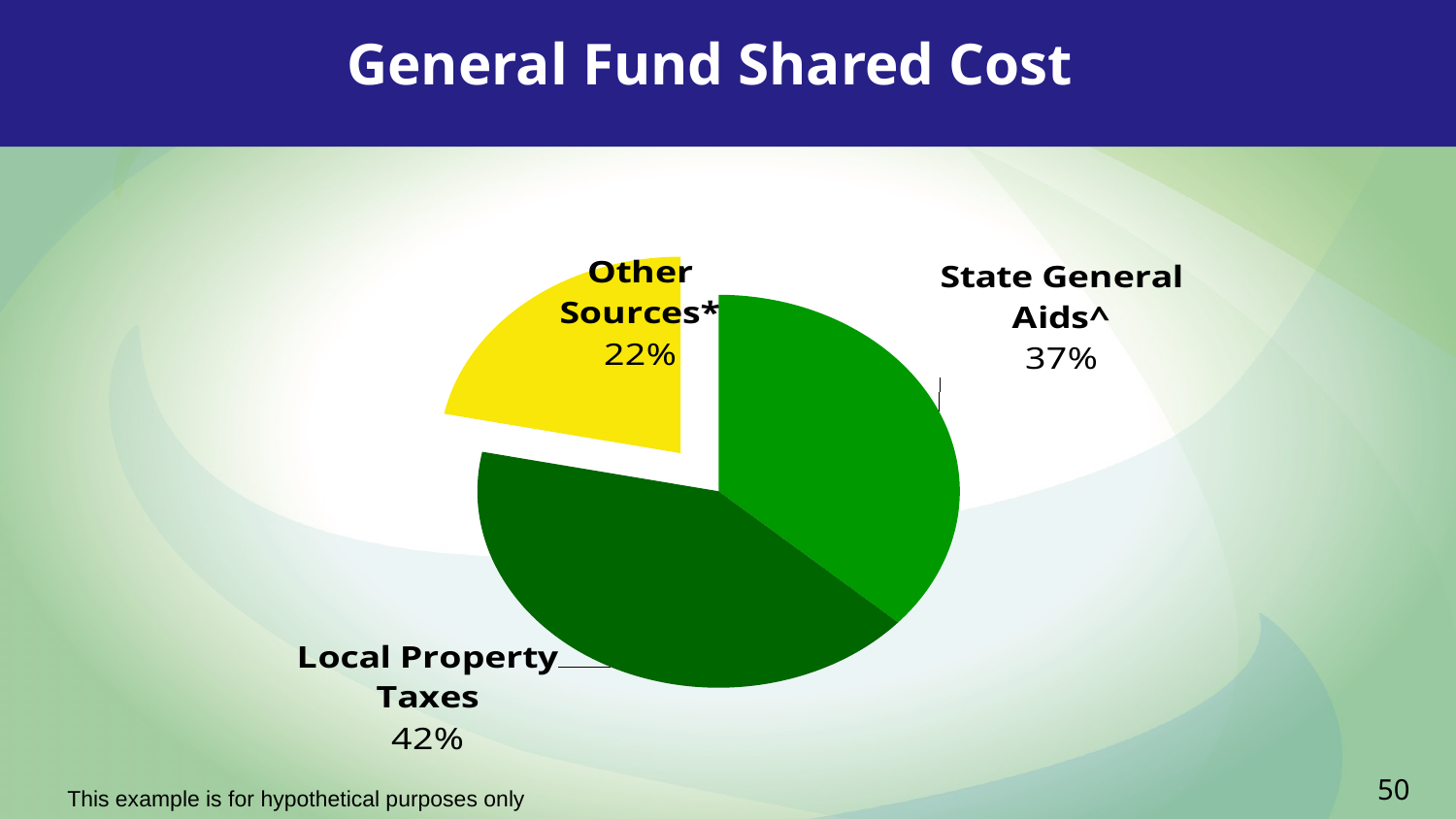
How many slices does the pie chart have? 3 Which slice is the smallest? Other Sources* What is the difference in percentage points between Local Property Taxes and Other Sources*? 20 Which is larger, State General Aids^ or Other Sources*? State General Aids^ What colour is the Other Sources* slice? Yellow What is the title of the slide? General Fund Shared Cost What share of the pie is Local Property Taxes? 42% Which slice is the largest? Local Property Taxes What share of the pie is State General Aids^? 37% What share of the pie is Other Sources*? 22% What kind of chart is shown on the slide? Pie chart What is the difference in percentage points between Local Property Taxes and State General Aids^? 5